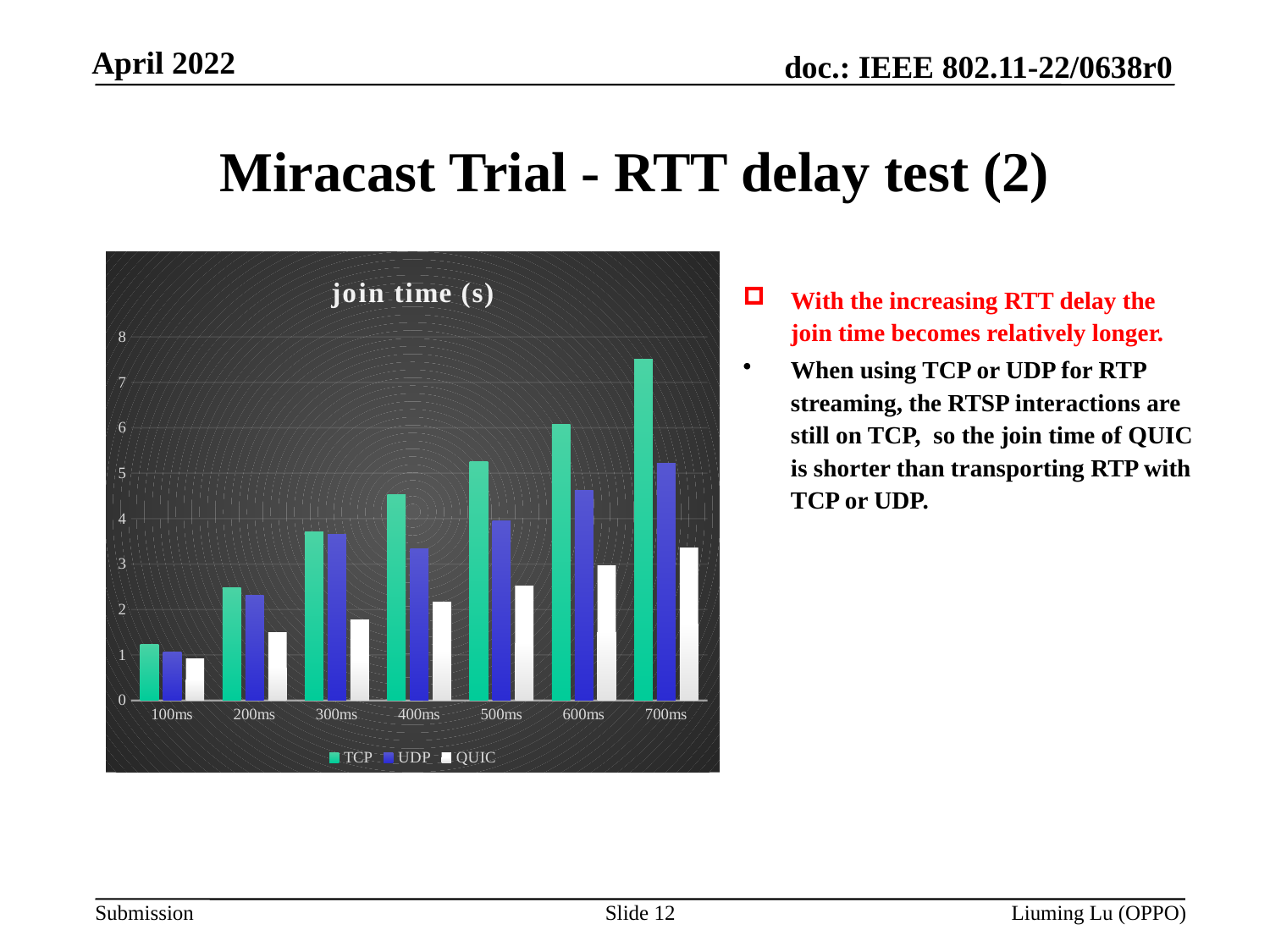
How many series does the chart's legend list? 3 How many RTT delay categories are shown on the x axis? 7 At 700ms, which has the larger join time, UDP or QUIC? UDP At 400ms, which has the larger join time, TCP or UDP? TCP Which series are listed in the chart's legend? TCP, UDP, QUIC What kind of chart is shown on the slide? bar chart What is the title of the chart? join time (s) At which RTT delay is the QUIC join time lowest? 100ms At which RTT delay is the TCP join time highest? 700ms Is the TCP join time at 700ms greater or less than 7? greater Does the TCP join time rise or fall as the RTT delay increases from 100ms to 700ms? rise Is the UDP join time at 600ms greater or less than 4? greater